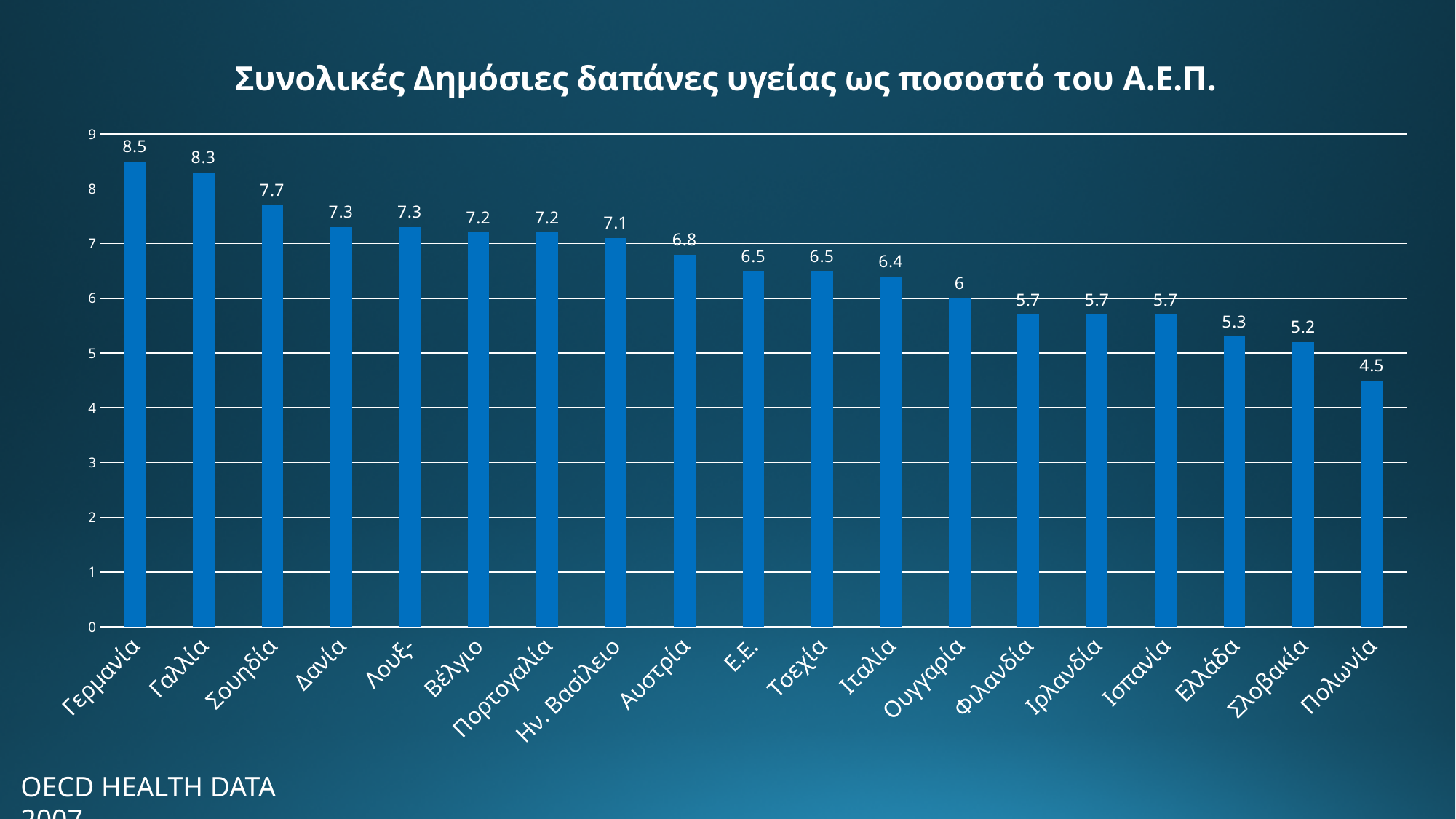
What is the difference between the values for Γερμανία and Πολωνία? 4 What is the value for Ελλάδα? 5.3 Which country has the highest value? Γερμανία What is the value for Ουγγαρία? 6 Which country has the lowest value? Πολωνία How many countries/categories are shown on the chart? 19 What kind of chart is shown on the slide? Bar chart What is the difference between the values for Γαλλία and Ελλάδα? 3 What is the value for Ε.Ε.? 6.5 What is the value for Γερμανία? 8.5 Which is larger, the value for Σουηδία or the value for Ιταλία? Σουηδία What is the title of the chart? Συνολικές Δημόσιες δαπάνες υγείας ως ποσοστό του Α.Ε.Π.